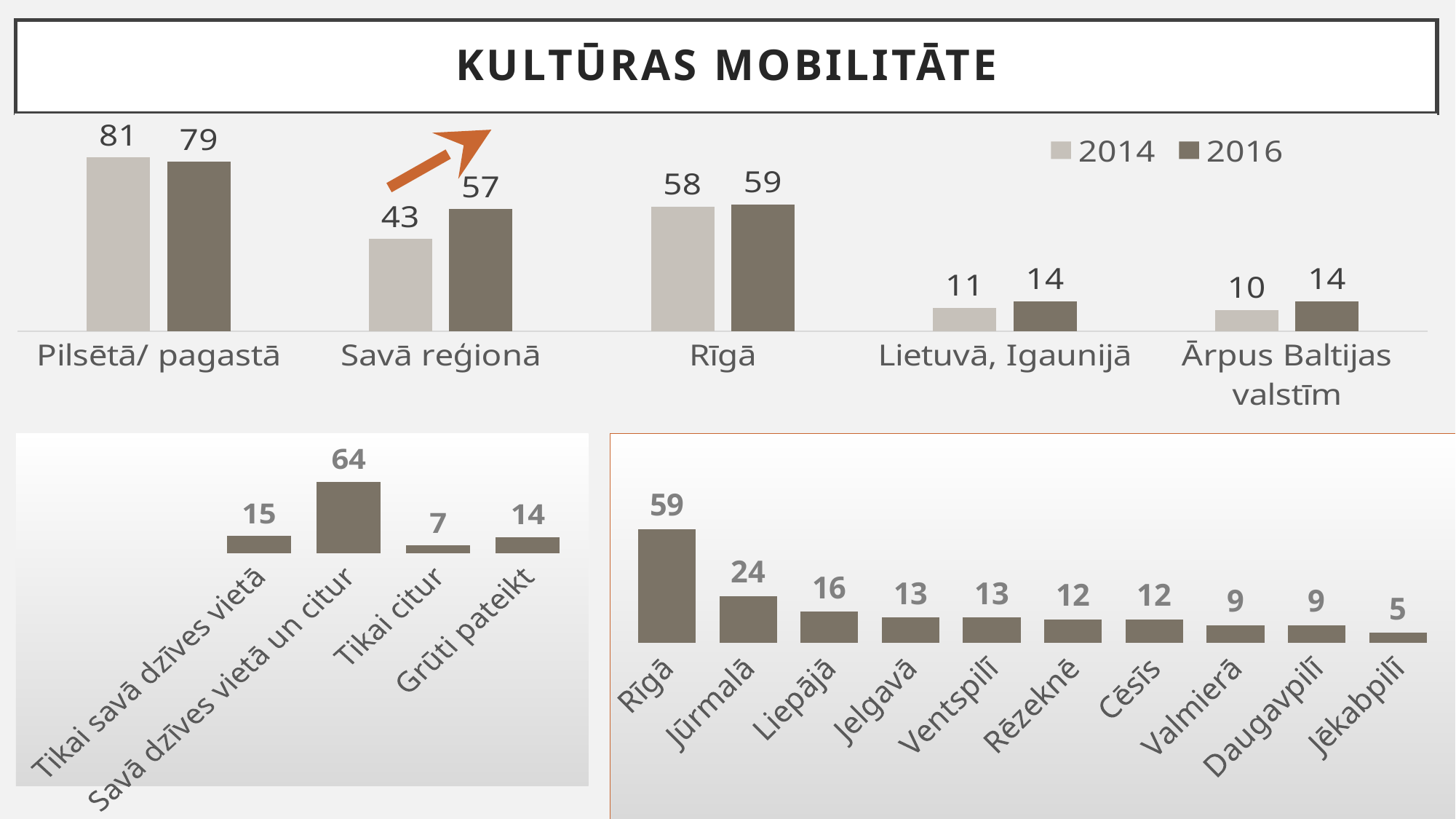
In the bottom-right chart, what is the difference between the values for Rīgā and Jēkabpilī? 54 In the top chart, how many series does the legend list? 2 In the top chart, is the 2014 value for Rīgā larger or the 2016 value for Rīgā? 2016 In the top chart, which category has the lowest 2014 value? Ārpus Baltijas valstīm In the top chart, what is the 2016 value for Savā reģionā? 57 In the top chart, what is the difference between the 2016 and 2014 values for Savā reģionā? 14 In the bottom-left chart, how many categories are shown? 4 In the bottom-left chart, which category has the highest value? Savā dzīves vietā un citur In the bottom-right chart, how many cities are shown? 10 In the top chart, what is the 2014 value for Pilsētā/ pagastā? 81 In the bottom-right chart, what is the value for Jūrmalā? 24 In the bottom-left chart, what is the value for Tikai citur? 7